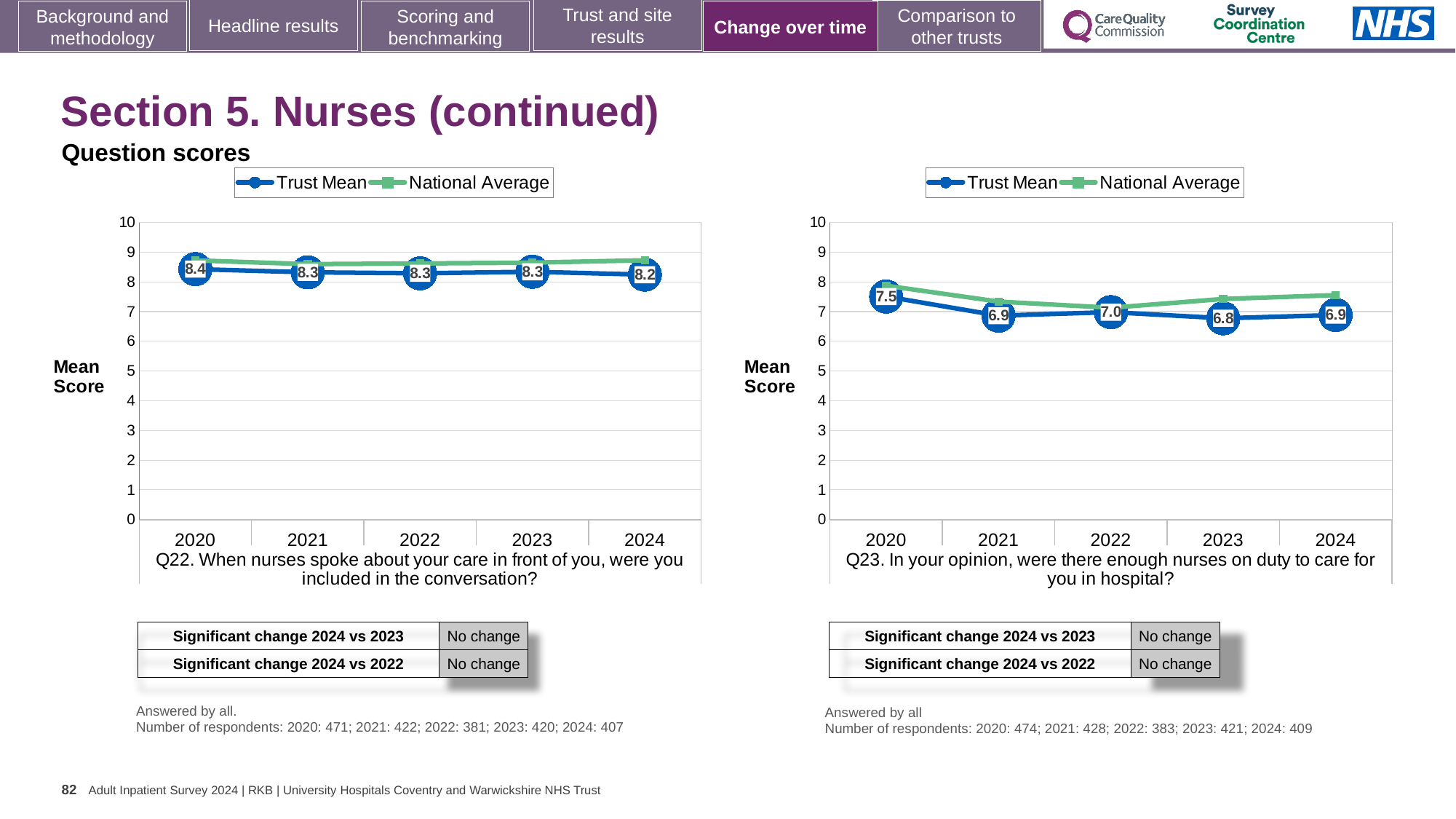
How many series does the legend of the Q23 chart on the right list? 2 In the Q23 chart on the right, which year has the highest Trust Mean score? 2020 In the Q23 chart on the right, what is the Trust Mean score for 2023? 6.8 In the Q23 chart on the right, is the National Average value for 2024 greater or less than 7? greater What kind of chart is the Q22 chart on the left? Line chart In the Q22 chart on the left, is the Trust Mean score for 2020 or 2024 larger? 2020 In the Q23 chart on the right, which year has the lowest Trust Mean score? 2023 How many years are plotted on the x axis of the Q22 chart on the left? 5 In the Q22 chart on the left, what is the Trust Mean score for 2024? 8.2 In the Q22 chart on the left, what is the Trust Mean score for 2020? 8.4 In the Q23 chart on the right, what is the difference between the Trust Mean scores for 2020 and 2024? 0.6 In the Q22 chart on the left, which year has the lowest Trust Mean score? 2024